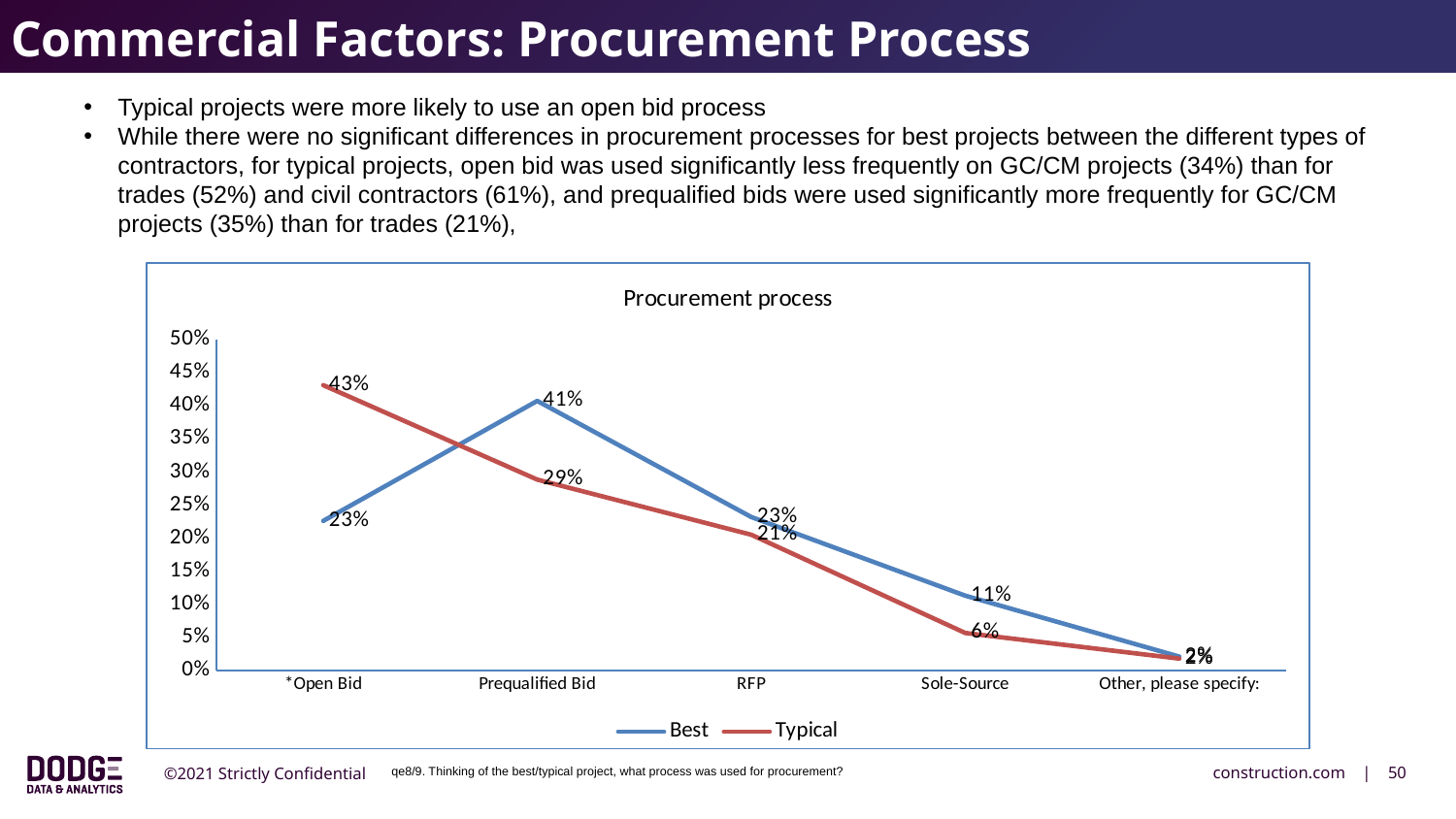
What type of chart is shown on the slide? line chart How many procurement process categories are shown on the x axis? 5 How many series does the legend list? 2 Which procurement process has the highest Typical value? *Open Bid What is the Best value for RFP? 23% What is the Best value for Prequalified Bid? 41% What is the Typical value for Sole-Source? 6% What is the difference between the Typical and Best values for Open Bid? 20% Which procurement process has the highest Best value? Prequalified Bid What is the title of the chart? Procurement process For Prequalified Bid, which series has the larger value, Best or Typical? Best What is the Typical value for Open Bid? 43%